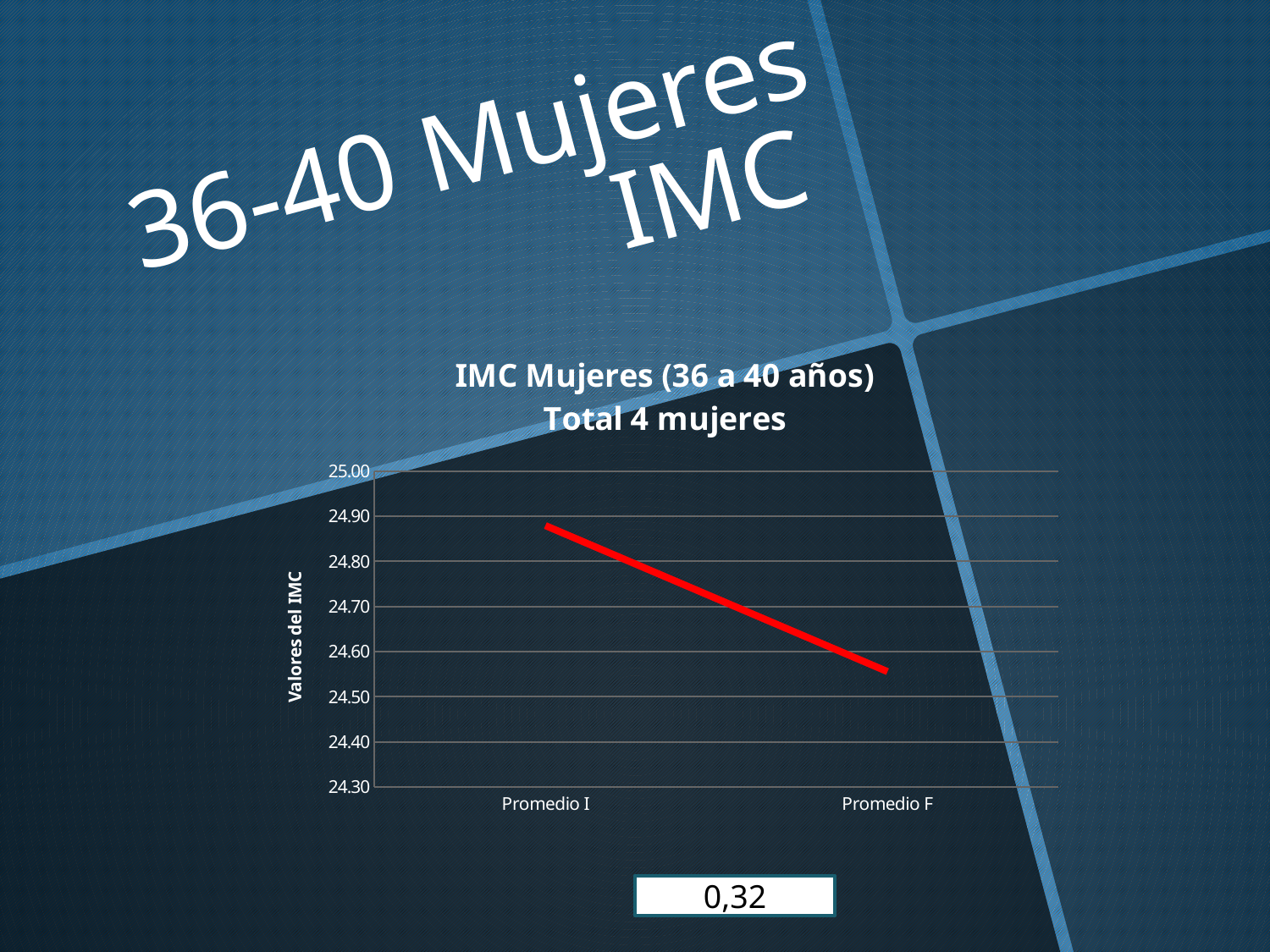
Is the value for Promedio I greater or less than 24.80? greater Which category has the lowest value in the chart? Promedio F Is the value for Promedio F greater or less than 24.60? less Which category has the higher value, Promedio I or Promedio F? Promedio I How many points are plotted on the line in the chart? 2 What is the title of the chart? IMC Mujeres (36 a 40 años) Total 4 mujeres Do the values rise or fall from Promedio I to Promedio F? fall Is the value for Promedio I greater or less than 25.00? less Which category has the highest value in the chart? Promedio I What is the label of the vertical axis of the chart? Valores del IMC What kind of chart is shown on the slide? line chart